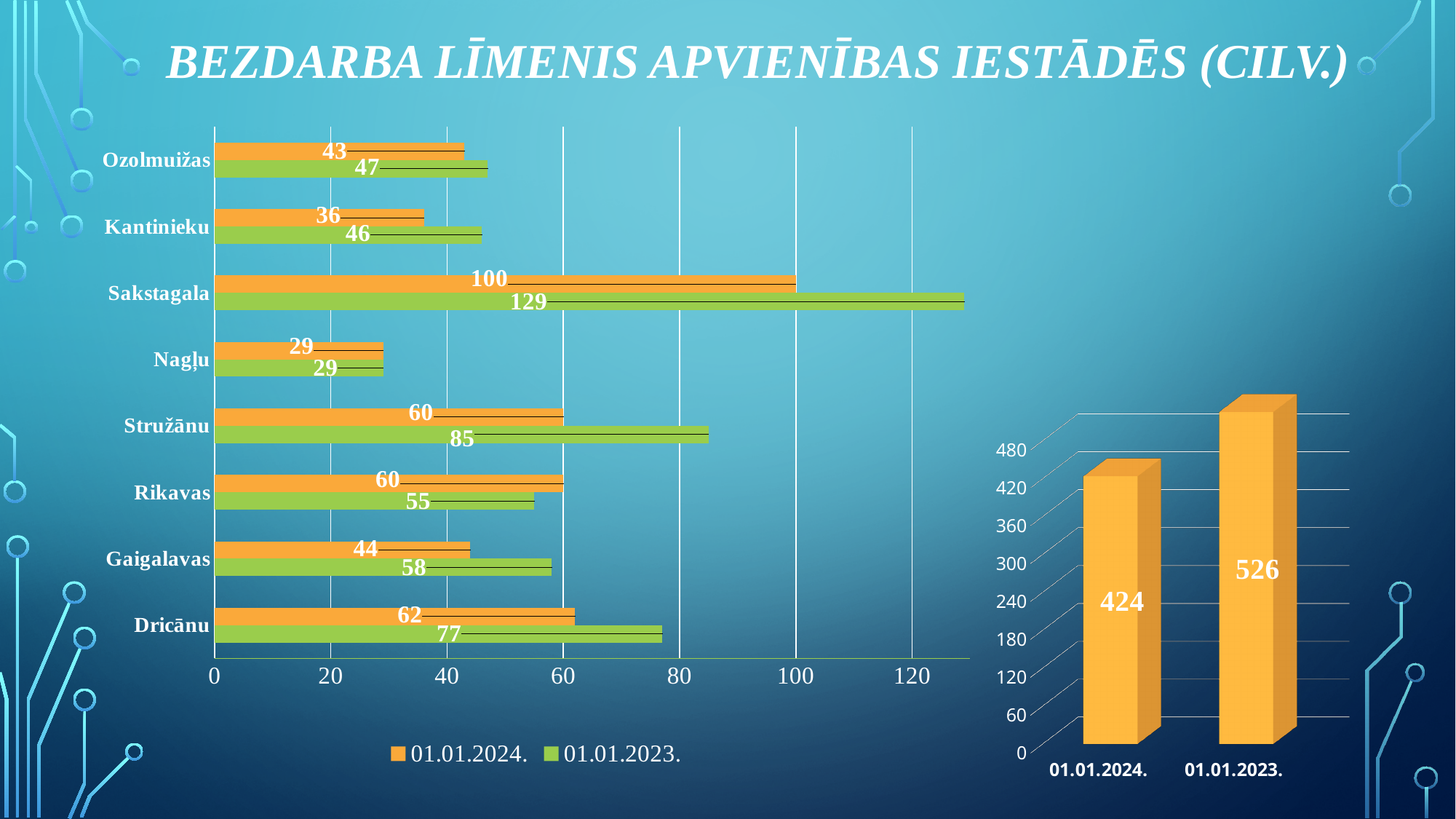
In the left bar chart, which category has the lowest value for 01.01.2023.? Nagļu How many series does the legend of the left bar chart list? 2 In the left bar chart, which is larger for Rikavas: the 01.01.2024. value or the 01.01.2023. value? 01.01.2024. In the left bar chart, which category has the highest value for 01.01.2024.? Sakstagala What kind of chart is the chart on the left of the slide? Bar chart In the left bar chart, which colour represents the 01.01.2023. series? Green In the left bar chart, what is the value for Kantinieku for 01.01.2024.? 36 In the right bar chart, what is the value for 01.01.2023.? 526 In the left bar chart, what is the value for Sakstagala for 01.01.2023.? 129 In the right bar chart, what is the difference between the 01.01.2023. and 01.01.2024. values? 102 How many categories are shown in the left bar chart? 8 In the left bar chart, what is the difference between the 01.01.2023. and 01.01.2024. values for Stružānu? 25